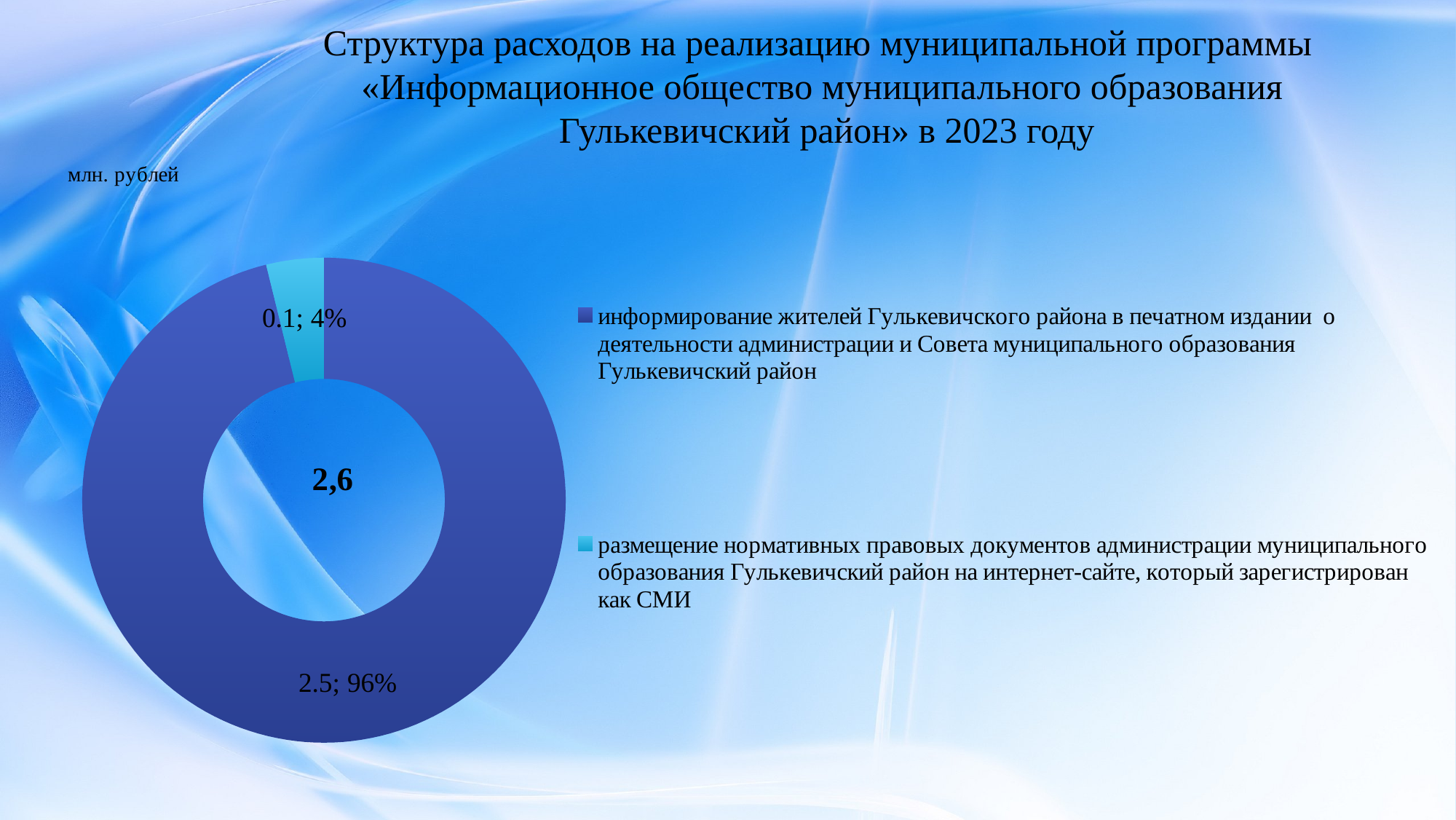
What is the difference between the value for informing residents in the print edition (2.5) and the value for placing documents on the website (0.1)? 2.4 What share of the chart does the slice for «размещение нормативных правовых документов ... на интернет-сайте» represent? 4% What share of the chart does the slice for «информирование жителей Гулькевичского района в печатном издании» represent? 96% Which category has the largest slice? информирование жителей Гулькевичского района в печатном издании о деятельности администрации и Совета муниципального образования Гулькевичский район In what units are the chart values given, according to the label above the chart? млн. рублей What kind of chart is shown on the slide? Doughnut (pie) chart Which category has the smallest slice? размещение нормативных правовых документов администрации муниципального образования Гулькевичский район на интернет-сайте, который зарегистрирован как СМИ What total value is shown in the centre of the doughnut chart? 2,6 How many categories does the chart show? 2 How many entries does the legend list? 2 What is the value for «размещение нормативных правовых документов администрации муниципального образования Гулькевичский район на интернет-сайте, который зарегистрирован как СМИ»? 0.1 What is the value for «информирование жителей Гулькевичского района в печатном издании о деятельности администрации и Совета муниципального образования Гулькевичский район»? 2.5